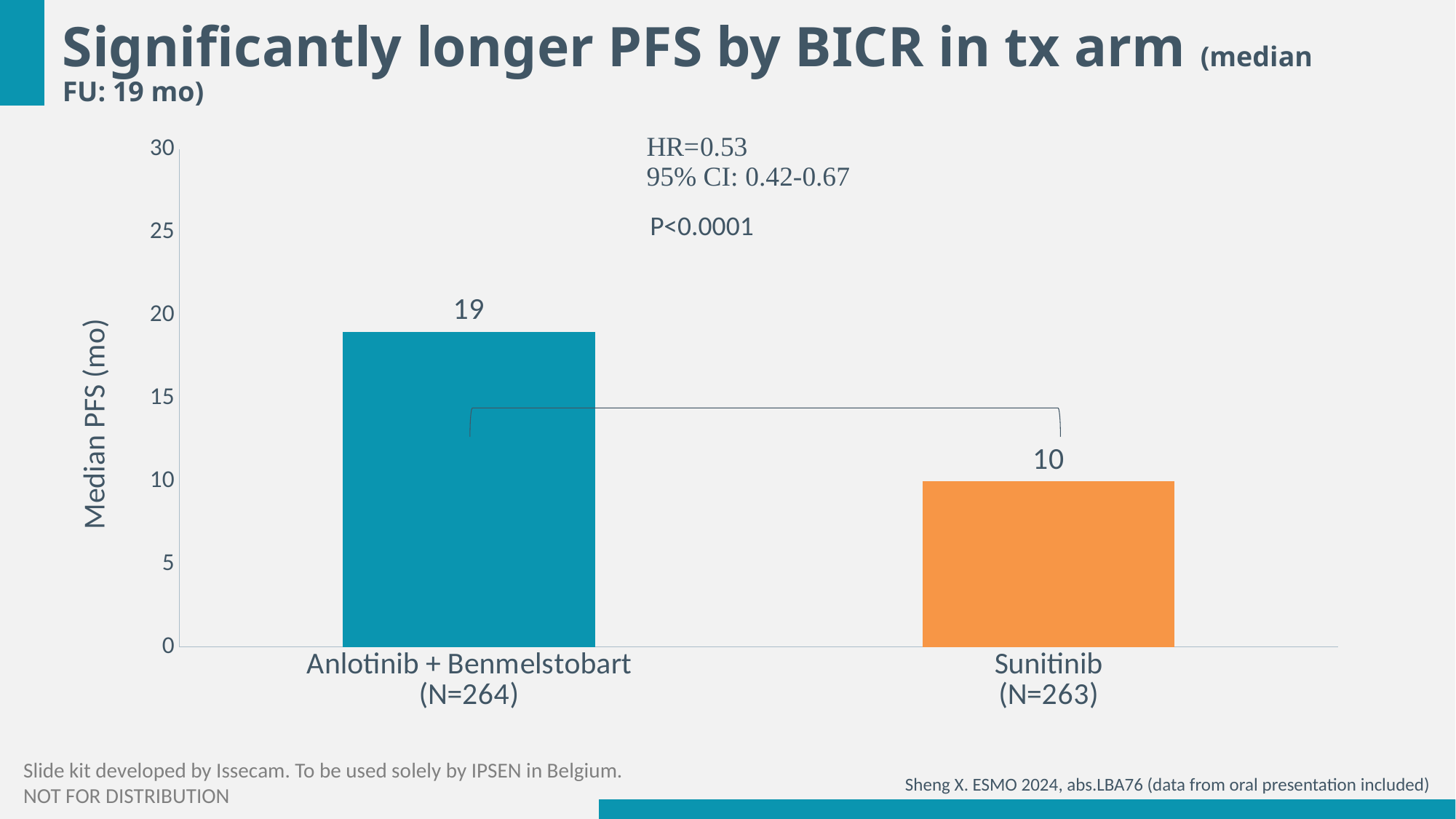
Is the median PFS for Anlotinib + Benmelstobart greater or less than 15? greater What is the label of the y axis? Median PFS (mo) What is the hazard ratio shown on the chart? 0.53 Which arm has the higher median PFS? Anlotinib + Benmelstobart What is the number of patients in the Sunitinib arm? 263 How many treatment arms are shown in the chart? 2 Which arm has the lower median PFS? Sunitinib What is the median PFS for Anlotinib + Benmelstobart? 19 What kind of chart is shown on the slide? bar chart What is the difference in median PFS between Anlotinib + Benmelstobart and Sunitinib? 9 What is the median PFS for Sunitinib? 10 Is the median PFS for Sunitinib greater or less than 15? less